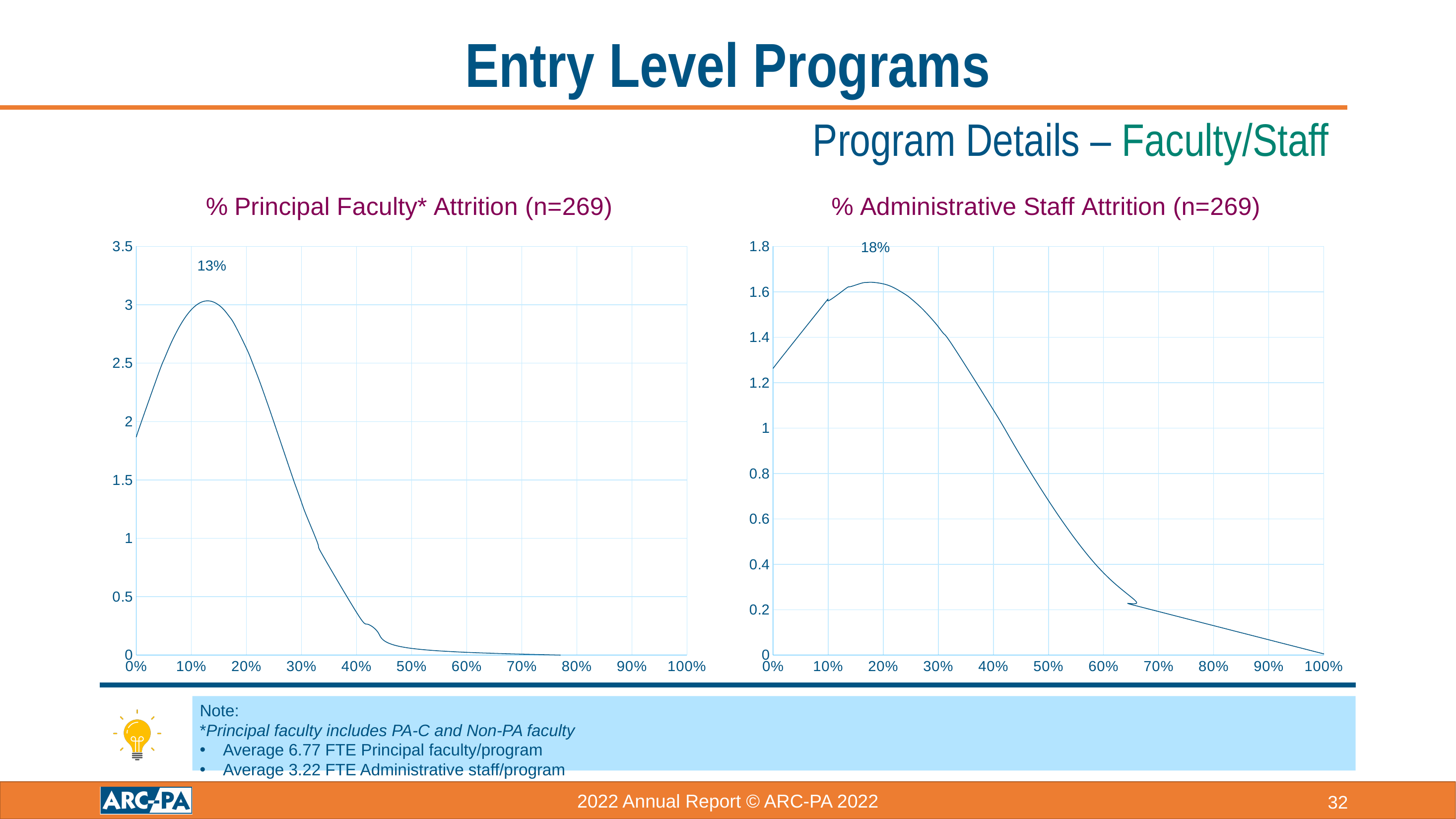
In the '% Administrative Staff Attrition (n=269)' chart, is the peak value of the curve greater or less than 1.4? greater How many tick labels are shown on the x axis of the '% Principal Faculty* Attrition (n=269)' chart? 11 What kind of chart is the '% Administrative Staff Attrition (n=269)' chart? line chart What sample size (n) is given in the title of the '% Administrative Staff Attrition' chart? 269 In the '% Principal Faculty* Attrition (n=269)' chart, what attrition percentage is labelled at the peak of the curve? 13% What kind of chart is the '% Principal Faculty* Attrition (n=269)' chart? line chart In the '% Principal Faculty* Attrition (n=269)' chart, is the curve higher at 0% or at 50%? 0% In the '% Principal Faculty* Attrition (n=269)' chart, is the value of the curve at 50% greater or less than 0.5? less In the '% Administrative Staff Attrition (n=269)' chart, does the curve rise or fall between 20% and 100% on the x axis? fall In the '% Administrative Staff Attrition (n=269)' chart, is the value of the curve at 0% greater or less than 1? greater In the '% Administrative Staff Attrition (n=269)' chart, what attrition percentage is labelled at the peak of the curve? 18%